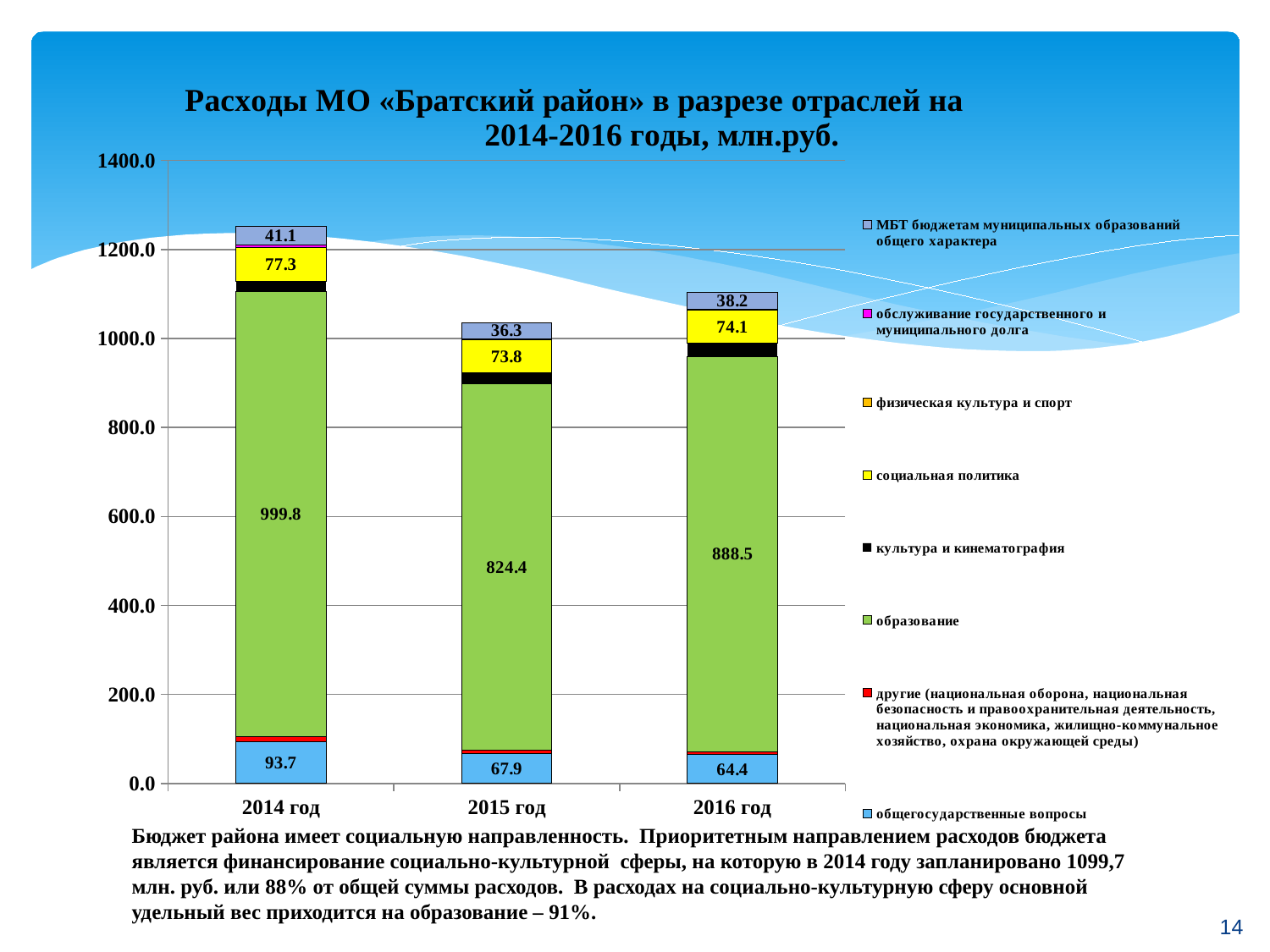
What is the difference between the образование values for 2014 год and 2015 год? 175.4 What is the value for социальная политика in 2015 год? 73.8 How many series does the legend list? 8 What is the value for образование in 2014 год? 999.8 Is the total height of the 2015 год bar greater or less than 1000.0? greater What type of chart is shown on the slide? stacked bar chart In which year is the value for общегосударственные вопросы the lowest? 2016 год What is the value for общегосударственные вопросы in 2016 год? 64.4 In which year is the value for образование the highest? 2014 год What is the value for МБТ бюджетам муниципальных образований общего характера in 2014 год? 41.1 Which is larger: the социальная политика value in 2016 год or in 2015 год? 2016 год How many years (categories) are shown on the x axis? 3